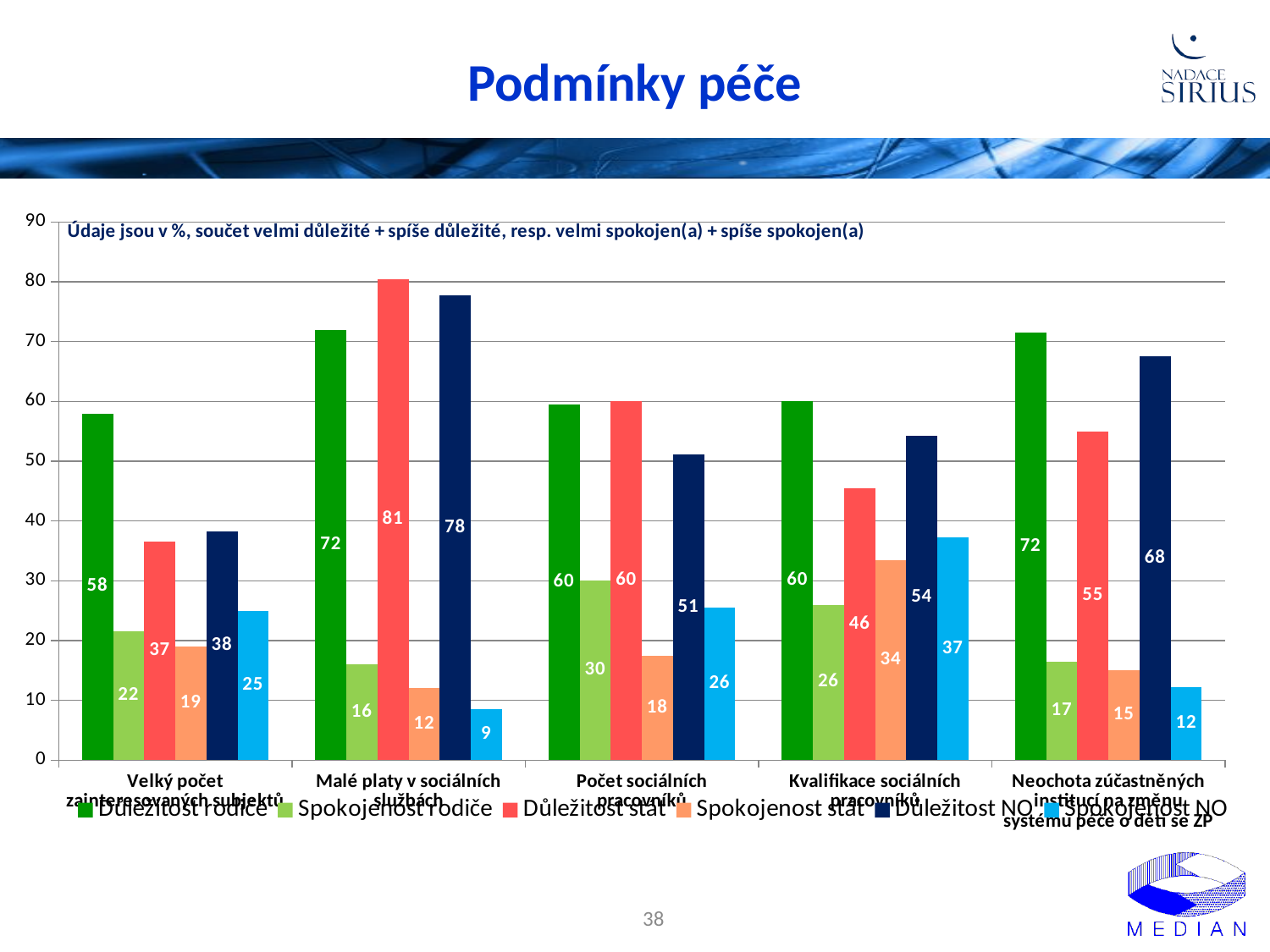
How many series does the legend list? 6 What is the difference between Důležitost NO and Spokojenost NO in the category Malé platy v sociálních službách? 69 Which series has the highest value in the category Malé platy v sociálních službách? Důležitost stát What is the value for Spokojenost NO in the category Kvalifikace sociálních pracovníků? 37 Which is larger in the category Velký počet zainteresovaných subjektů: Důležitost rodiče or Důležitost NO? Důležitost rodiče How many categories are shown on the x axis? 5 What is the value for Důležitost stát in the category Malé platy v sociálních službách? 81 Which series has the lowest value in the category Neochota zúčastněných institucí na změnu systému péče o děti se ZP? Spokojenost NO What kind of chart is shown on the slide? bar chart What is the value for Spokojenost rodiče in the category Počet sociálních pracovníků? 30 What is the title of the slide? Podmínky péče Is the value for Důležitost NO in the category Neochota zúčastněných institucí na změnu systému péče o děti se ZP greater or less than 60? greater